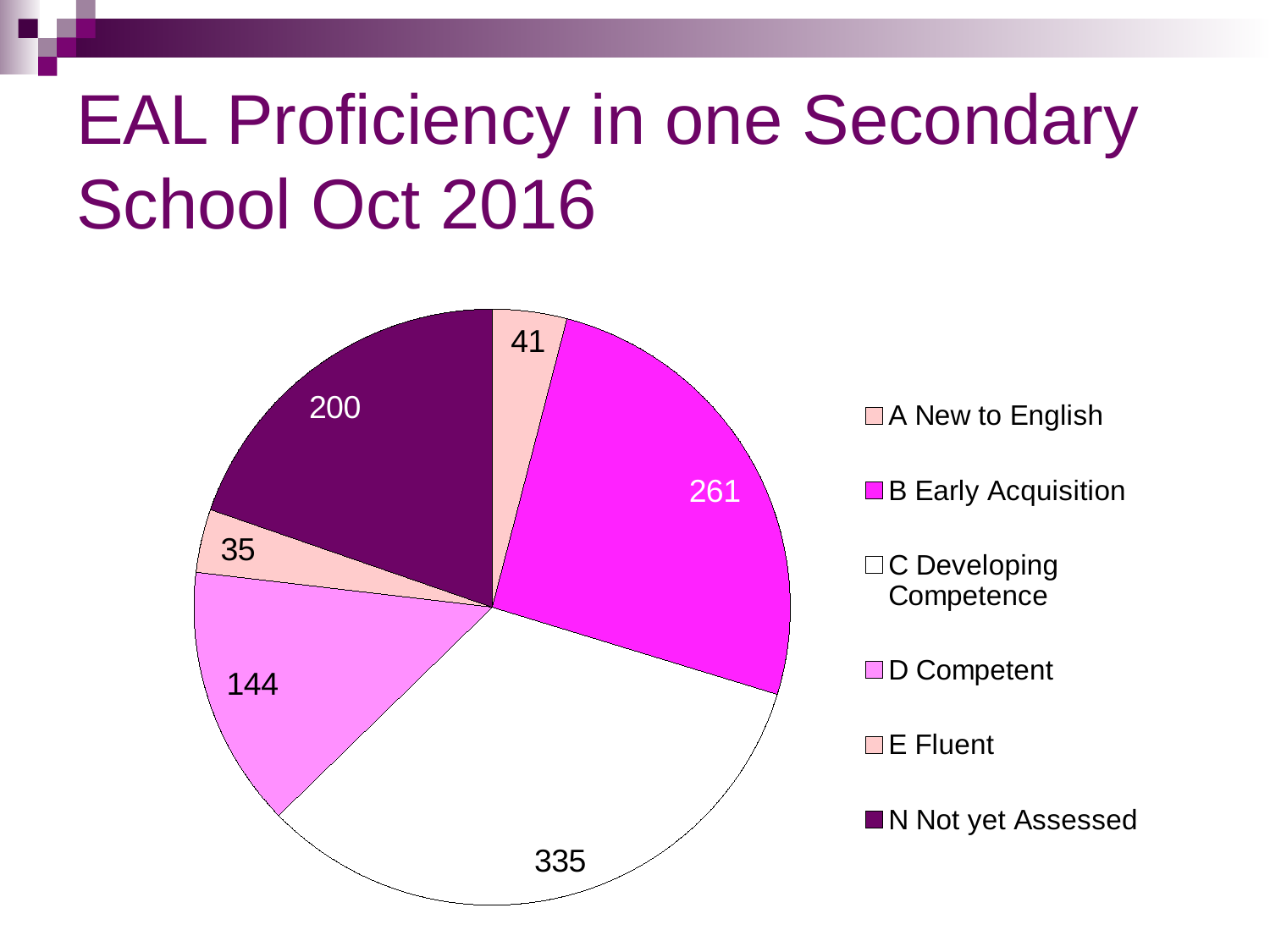
What is the value for E Fluent? 35 What kind of chart is shown on the slide? pie chart Which category has the smallest slice of the pie? E Fluent What is the difference between the values for C Developing Competence and B Early Acquisition? 74 How many categories does the pie chart have? 6 What is the value for N Not yet Assessed? 200 Which is larger, D Competent or N Not yet Assessed? N Not yet Assessed What is the title of the slide containing the chart? EAL Proficiency in one Secondary School Oct 2016 Which category has the largest slice of the pie? C Developing Competence How many pupils are in the C Developing Competence category? 335 What is the value for B Early Acquisition? 261 What is the total of all the slices in the pie chart? 1016